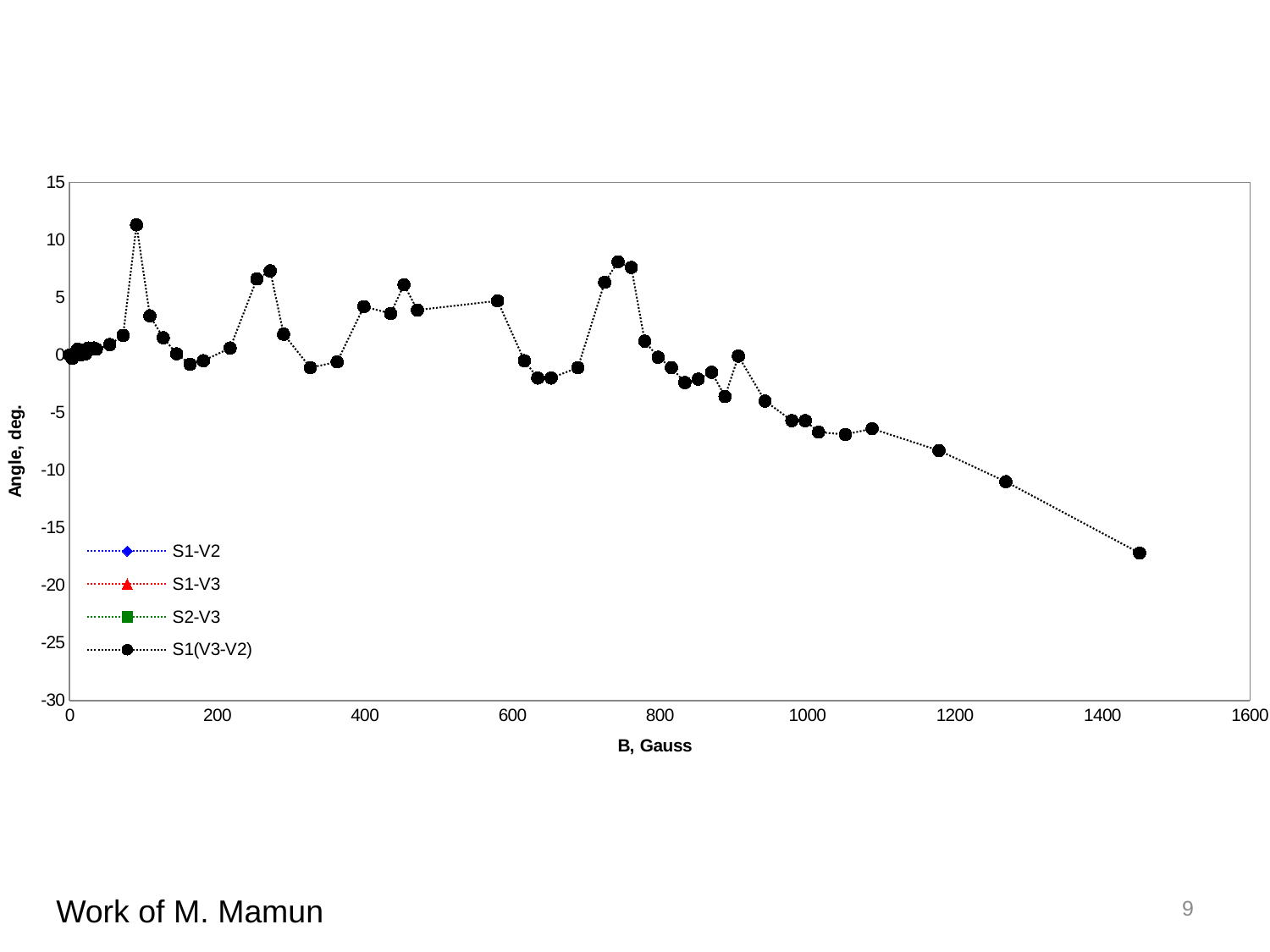
Is the value of the highest peak (near 90 Gauss) greater or less than 10? greater Is the value of the data point near 1000 Gauss greater or less than 0? less What is the title of the y axis? Angle, deg. Which series in the legend is plotted with black circle markers? S1(V3-V2) Is the value of the rightmost data point (near 1450 Gauss) greater or less than -15? less What kind of chart is shown on the slide? line chart Which is larger, the value of the data point near 1270 Gauss or the value of the data point near 1450 Gauss? near 1270 Gauss What is the title of the x axis? B, Gauss How many series does the legend list? 4 Do the plotted values generally rise or fall as B increases from 1000 to 1600 Gauss? fall